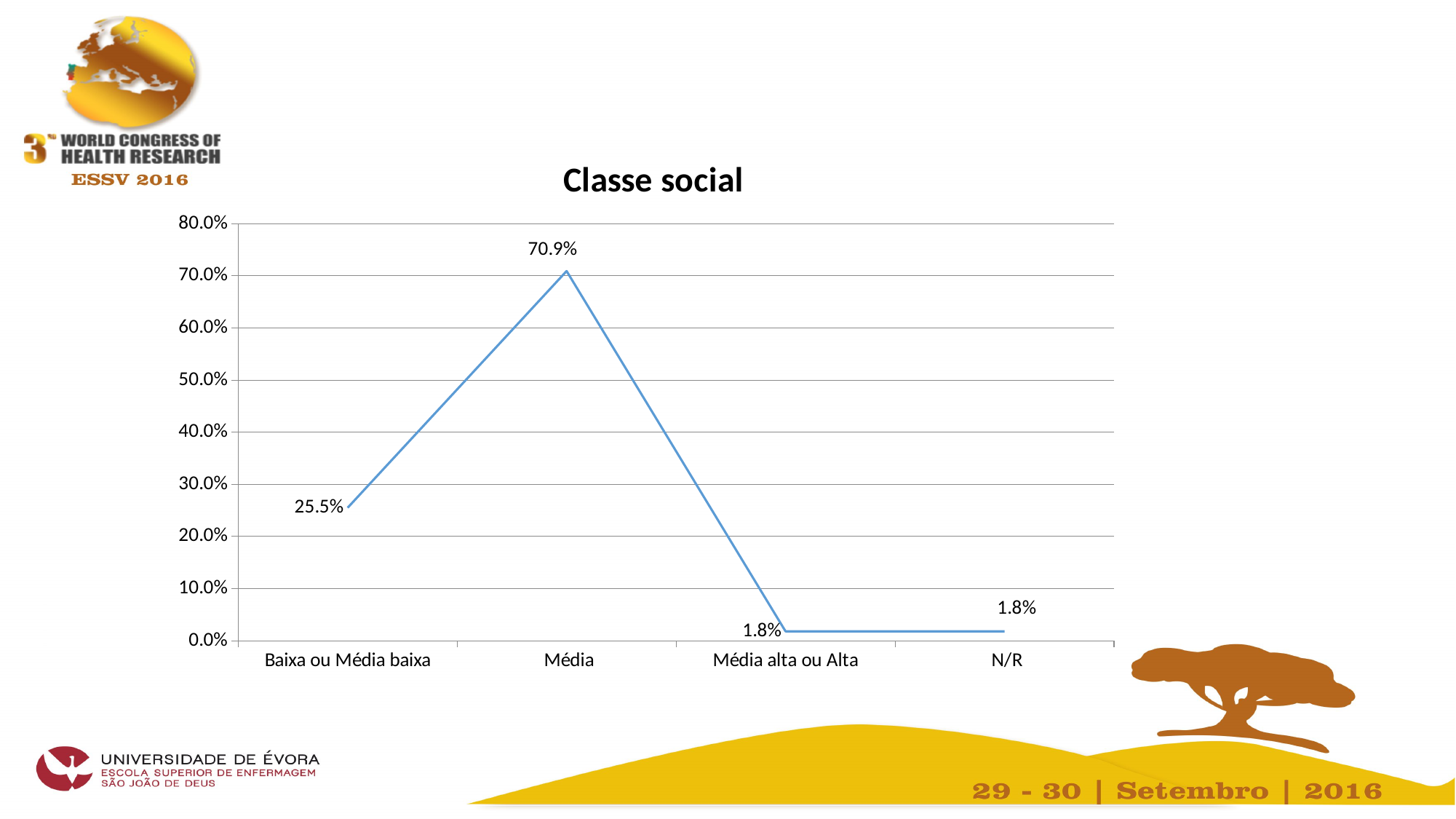
What is the difference between the values for Baixa ou Média baixa and Média alta ou Alta? 23.7% Which category has the highest value? Média What is the difference between the values for Média and Baixa ou Média baixa? 45.4% What is the value for Média? 70.9% What is the value for N/R? 1.8% What is the value for Baixa ou Média baixa? 25.5% How many categories are shown on the x axis? 4 What is the title of the chart? Classe social What kind of chart is shown on the slide? line chart Which is larger, the value for Baixa ou Média baixa or the value for Média? Média Is the value for Média greater or less than 60.0%? greater What is the value for Média alta ou Alta? 1.8%